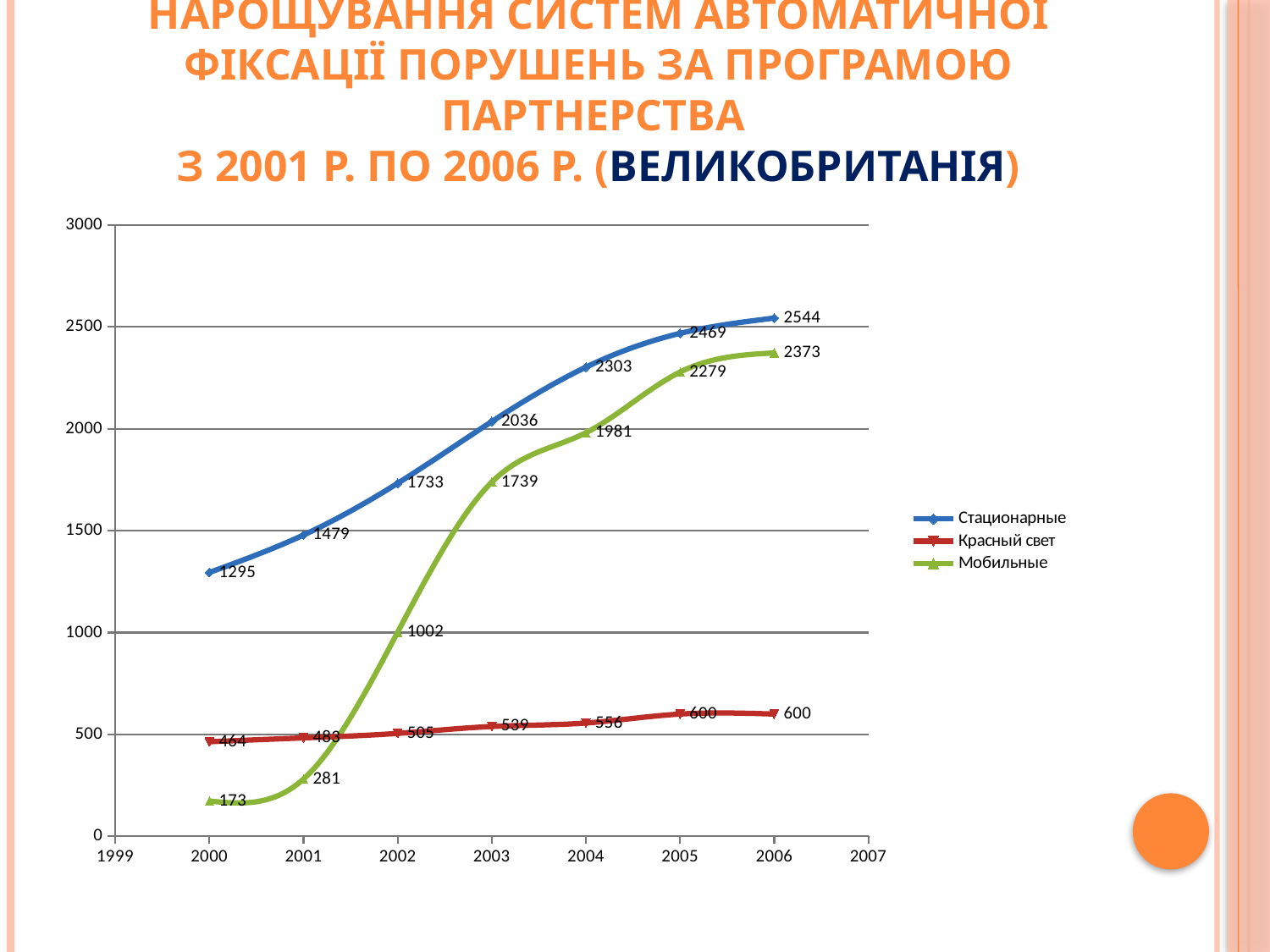
In which year is the Мобильные series lowest? 2000 What is the value for Мобильные in 2002? 1002 What kind of chart is shown on the slide? line chart How many series does the legend list? 3 What is the difference between the Стационарные and Мобильные values in 2006? 171 How many data points are plotted for the Красный свет series? 7 What is the value for Стационарные in 2006? 2544 In which year is the Стационарные series highest? 2006 Which series has the larger value in 2001, Красный свет or Мобильные? Красный свет Which series is drawn in green? Мобильные What is the value for Красный свет in 2003? 539 Does the Стационарные series rise or fall from 2000 to 2006? rise